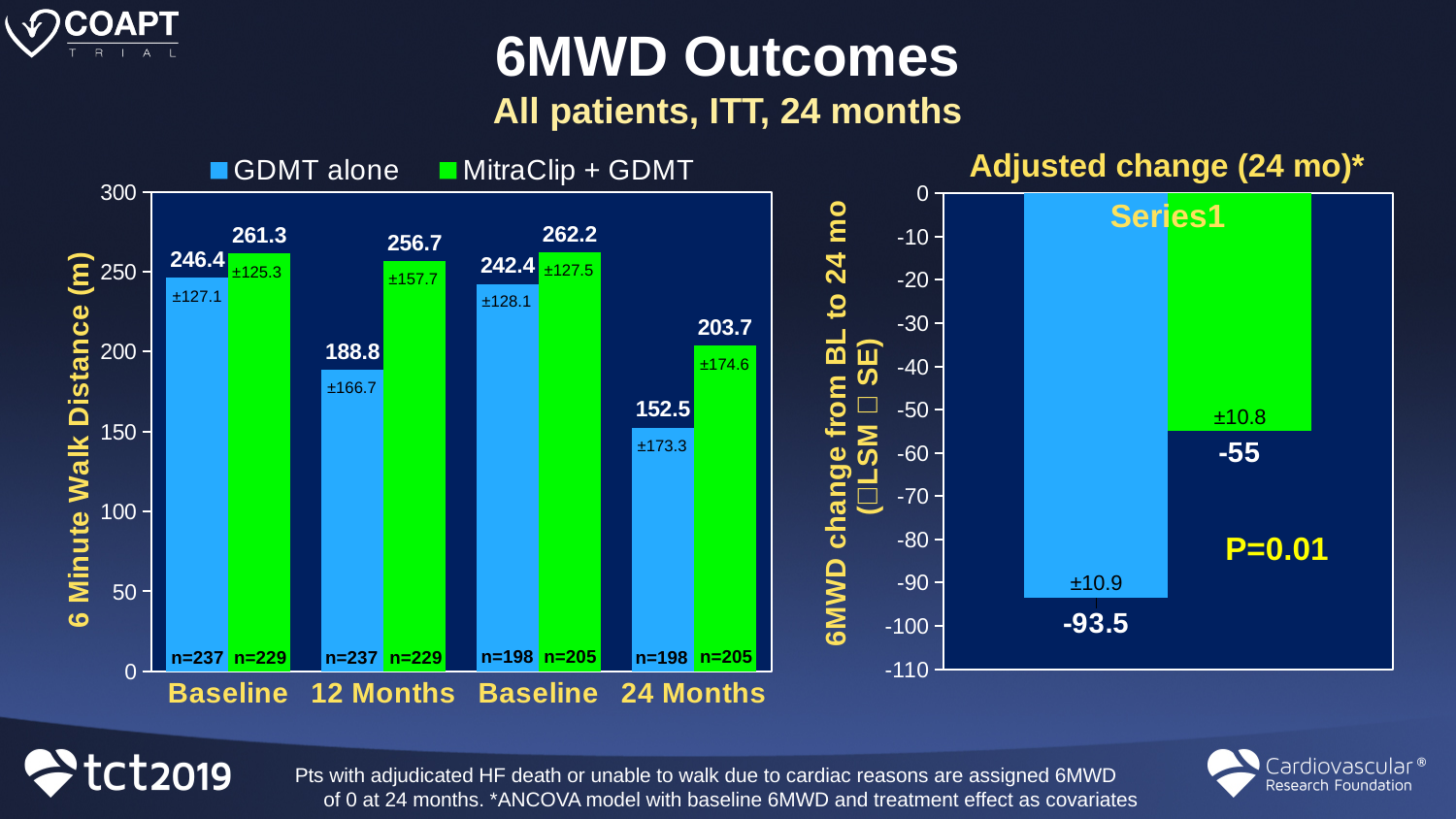
In the left chart, which bar has the lowest 6 Minute Walk Distance? GDMT alone at 24 Months (152.5) In the left chart, how many series does the legend list? 2 In the left chart, how many category groups are shown on the x axis? 4 What kind of chart is the left chart? Bar chart In the 'Adjusted change (24 mo)*' chart, what is the adjusted change for the green (MitraClip + GDMT) bar? -55 In the 'Adjusted change (24 mo)*' chart, what P value is shown? P=0.01 In the left chart, which is larger at 12 Months: GDMT alone or MitraClip + GDMT? MitraClip + GDMT In the left chart, what is the value for MitraClip + GDMT at the first Baseline? 261.3 In the left chart, what is the 6 Minute Walk Distance for MitraClip + GDMT at 24 Months? 203.7 In the left chart, what is the 6 Minute Walk Distance for GDMT alone at 12 Months? 188.8 In the 'Adjusted change (24 mo)*' chart, what is the adjusted change for the blue (GDMT alone) bar? -93.5 In the left chart, what is the difference between MitraClip + GDMT and GDMT alone at 24 Months? 51.2